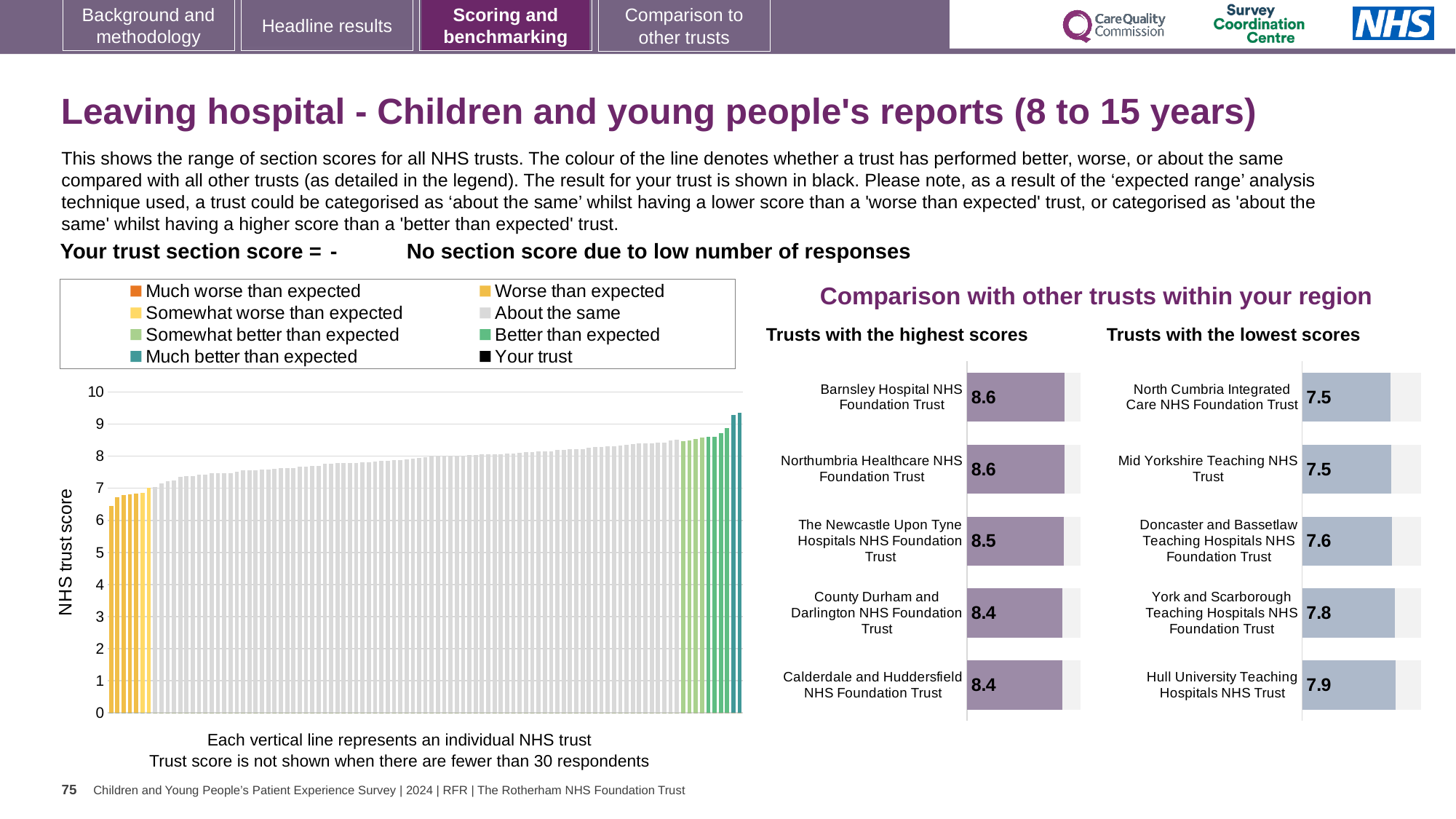
In the large 'NHS trust score' chart on the left, is the value of the tallest (rightmost) bar greater or less than 9? greater Which has the larger score: The Newcastle Upon Tyne Hospitals NHS Foundation Trust in the highest scores chart, or Doncaster and Bassetlaw Teaching Hospitals NHS Foundation Trust in the lowest scores chart? The Newcastle Upon Tyne Hospitals NHS Foundation Trust In the large 'NHS trust score' chart on the left, do the bars rise or fall from left to right? Rise In the 'Trusts with the lowest scores' chart, what is the difference between the scores of Hull University Teaching Hospitals NHS Trust and North Cumbria Integrated Care NHS Foundation Trust? 0.4 How many trusts are listed in the 'Trusts with the highest scores' chart? 5 What kind of chart is the large 'NHS trust score' chart on the left of the slide? Bar chart In the 'Trusts with the lowest scores' chart, which trust has the highest score? Hull University Teaching Hospitals NHS Trust According to the legend above the large 'NHS trust score' chart, what colour represents 'Your trust'? Black In the 'Trusts with the highest scores' chart, what is the score for The Newcastle Upon Tyne Hospitals NHS Foundation Trust? 8.5 In the 'Trusts with the lowest scores' chart, what is the score for York and Scarborough Teaching Hospitals NHS Foundation Trust? 7.8 How many categories does the legend above the large 'NHS trust score' chart list? 8 In the 'Trusts with the highest scores' chart, what is the score for Barnsley Hospital NHS Foundation Trust? 8.6